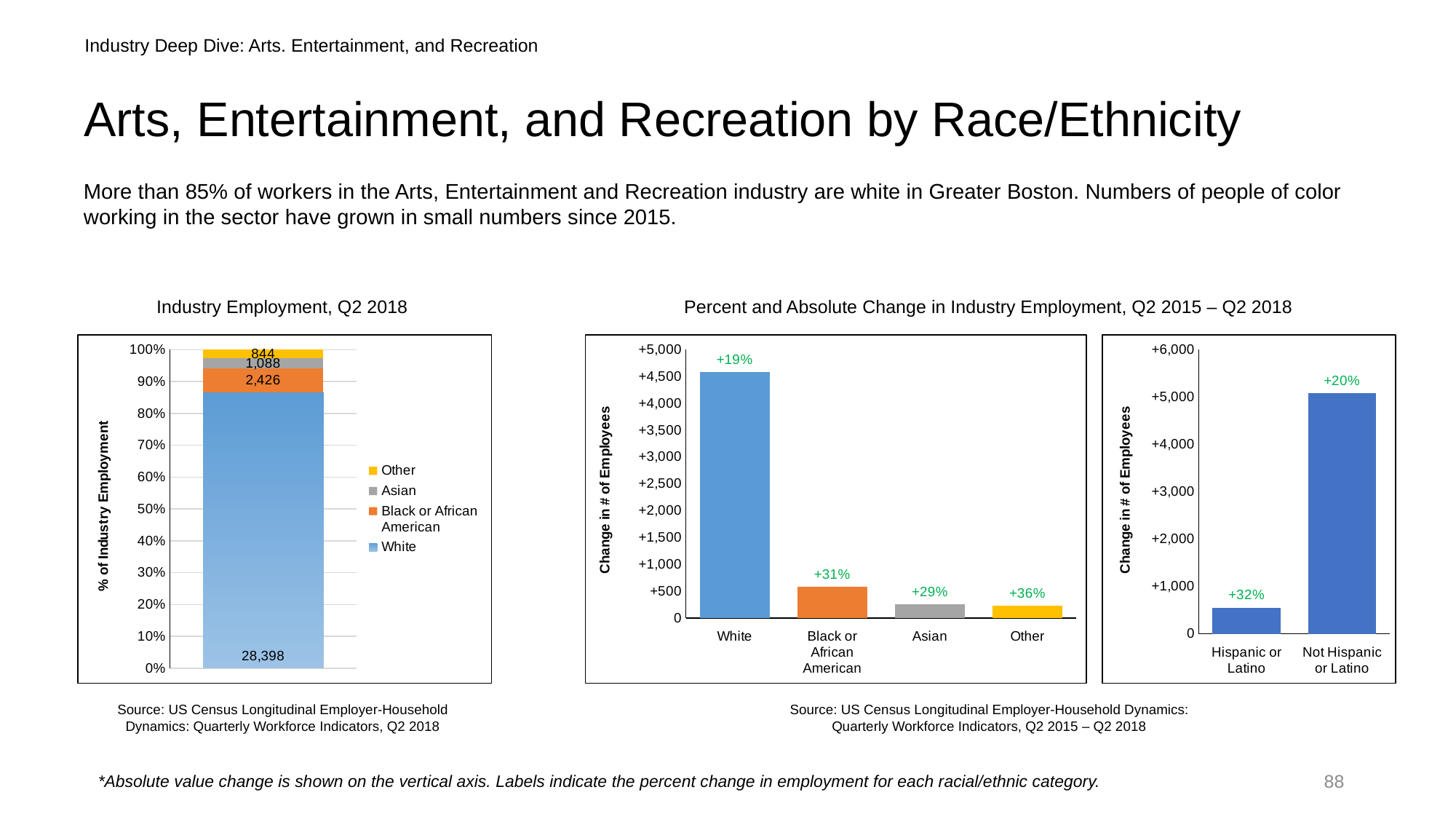
In the middle chart (Percent and Absolute Change in Industry Employment by race), which bar is taller: Black or African American or Asian? Black or African American In the middle chart (Percent and Absolute Change in Industry Employment by race), is the bar for White greater or less than +4,000? greater In the Industry Employment, Q2 2018 chart, what is the difference between the Black or African American value and the Asian value? 1,338 In the middle chart (Percent and Absolute Change in Industry Employment by race), is the bar for Asian greater or less than +500? less In the Industry Employment, Q2 2018 chart, what is the value shown for Asian? 1,088 In the middle chart (Percent and Absolute Change in Industry Employment by race), which category has the highest percent change label? Other How many series does the legend of the Industry Employment, Q2 2018 chart list? 4 In the middle chart (Percent and Absolute Change in Industry Employment by race), what percent change label is shown for Black or African American? +31% In the rightmost chart (change in employment by Hispanic or Latino status), what percent change label is shown for Hispanic or Latino? +32% In the rightmost chart (change in employment by Hispanic or Latino status), is the bar for Not Hispanic or Latino greater or less than +4,000? greater In the Industry Employment, Q2 2018 chart, what is the value shown for White? 28,398 In the Industry Employment, Q2 2018 chart, what is the total of all four segments of the stacked bar? 32,756